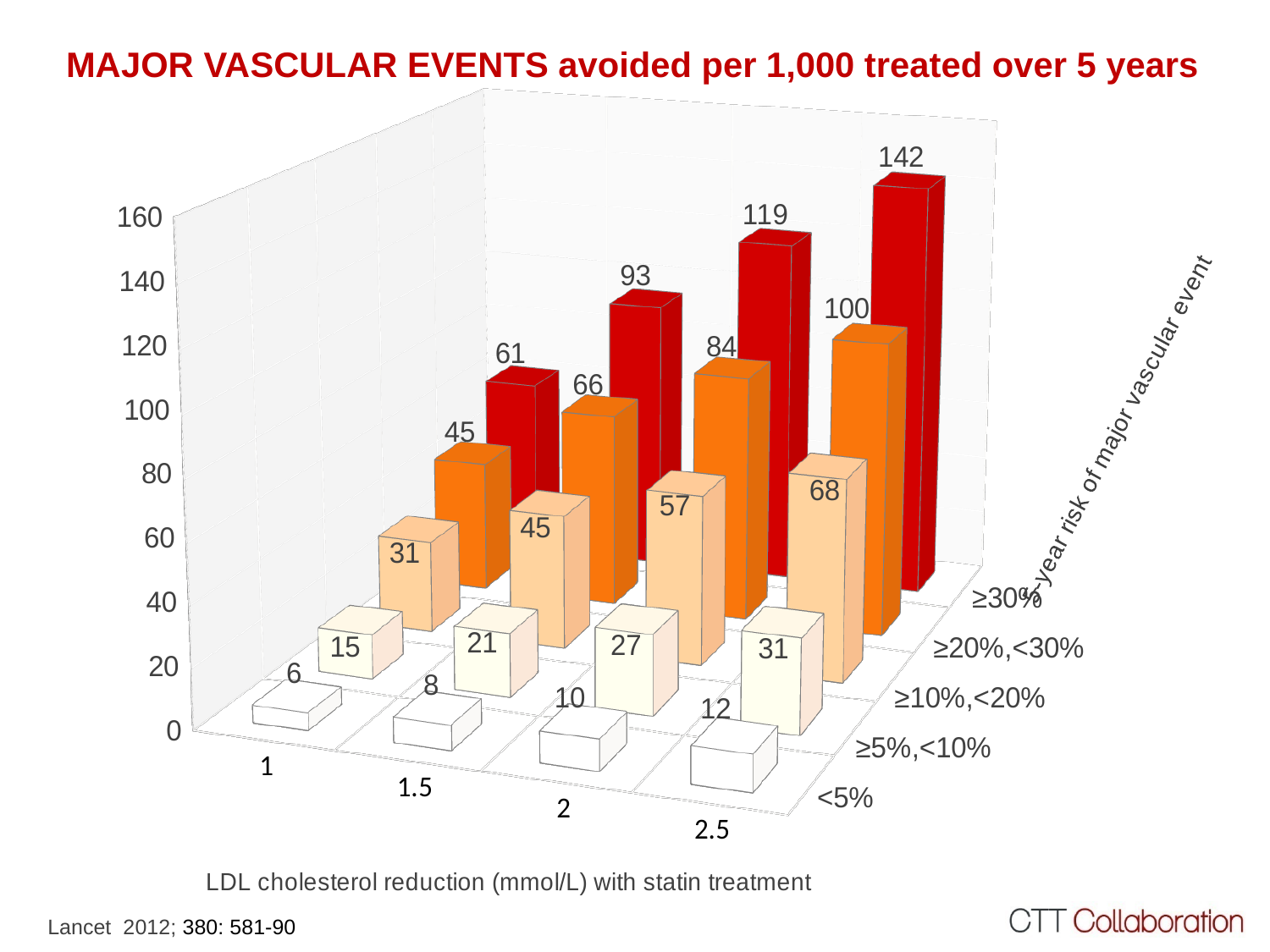
How many major vascular events are avoided per 1,000 treated for an LDL reduction of 2.5 mmol/L in the ≥30% risk group? 142 What is the value for an LDL reduction of 2 mmol/L in the ≥10%,<20% risk group? 57 How many LDL cholesterol reduction levels are shown on the x axis? 4 Do the values rise or fall as LDL cholesterol reduction increases within each risk group? rise Which combination of LDL reduction and risk group has the highest number of events avoided? 2.5 mmol/L, ≥30% What is the difference between the values for 2.5 mmol/L and 1 mmol/L in the ≥30% risk group? 81 What is the value for an LDL reduction of 1.5 mmol/L in the ≥20%,<30% risk group? 66 How many 5-year risk categories are shown on the chart? 5 Which is larger: the value for 2.5 mmol/L in the ≥20%,<30% group or the value for 2 mmol/L in the ≥30% group? 2 mmol/L in the ≥30% group Which combination of LDL reduction and risk group has the lowest number of events avoided? 1 mmol/L, <5% What kind of chart is shown on the slide? bar chart What is the value for an LDL reduction of 1 mmol/L in the <5% risk group? 6